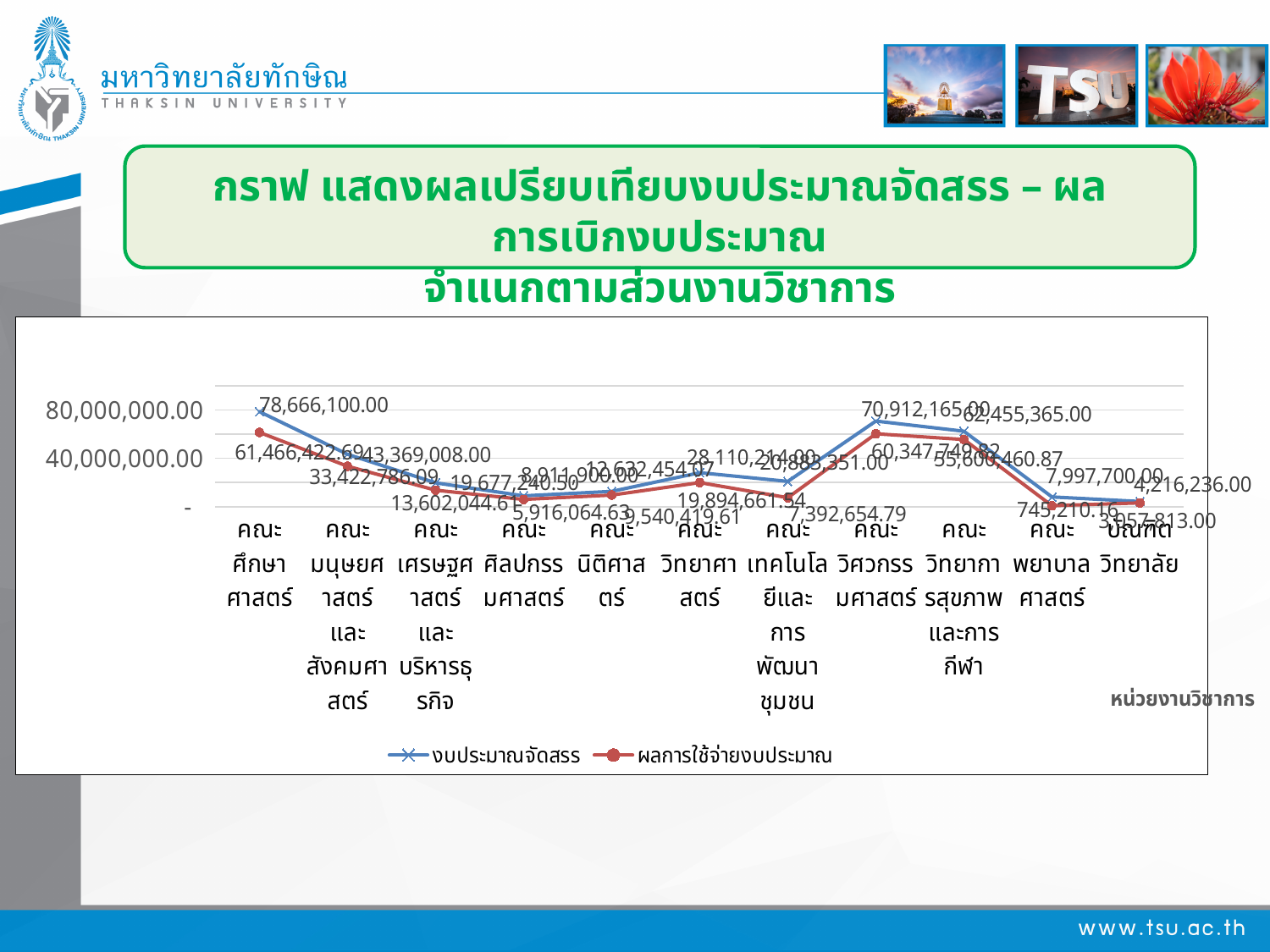
Is the งบประมาณจัดสรร value for คณะวิทยาการสุขภาพและการกีฬา greater or less than 40,000,000.00? greater What is the difference between งบประมาณจัดสรร and ผลการใช้จ่ายงบประมาณ for คณะศึกษาศาสตร์? 17,199,677.31 How many series does the legend list? 2 What kind of chart is shown on the slide? Line chart Which series is drawn in red with circle markers? ผลการใช้จ่ายงบประมาณ What is the ผลการใช้จ่ายงบประมาณ value for คณะพยาบาลศาสตร์? 745,210.16 What is the งบประมาณจัดสรร value for คณะศึกษาศาสตร์? 78,666,100.00 Which academic unit has the lowest ผลการใช้จ่ายงบประมาณ? คณะพยาบาลศาสตร์ Which academic unit has the highest งบประมาณจัดสรร? คณะศึกษาศาสตร์ Which is larger for คณะวิศวกรรมศาสตร์: งบประมาณจัดสรร or ผลการใช้จ่ายงบประมาณ? งบประมาณจัดสรร What is the ผลการใช้จ่ายงบประมาณ value for คณะวิศวกรรมศาสตร์? 60,347,749.82 How many academic units (categories) are plotted along the x axis? 11